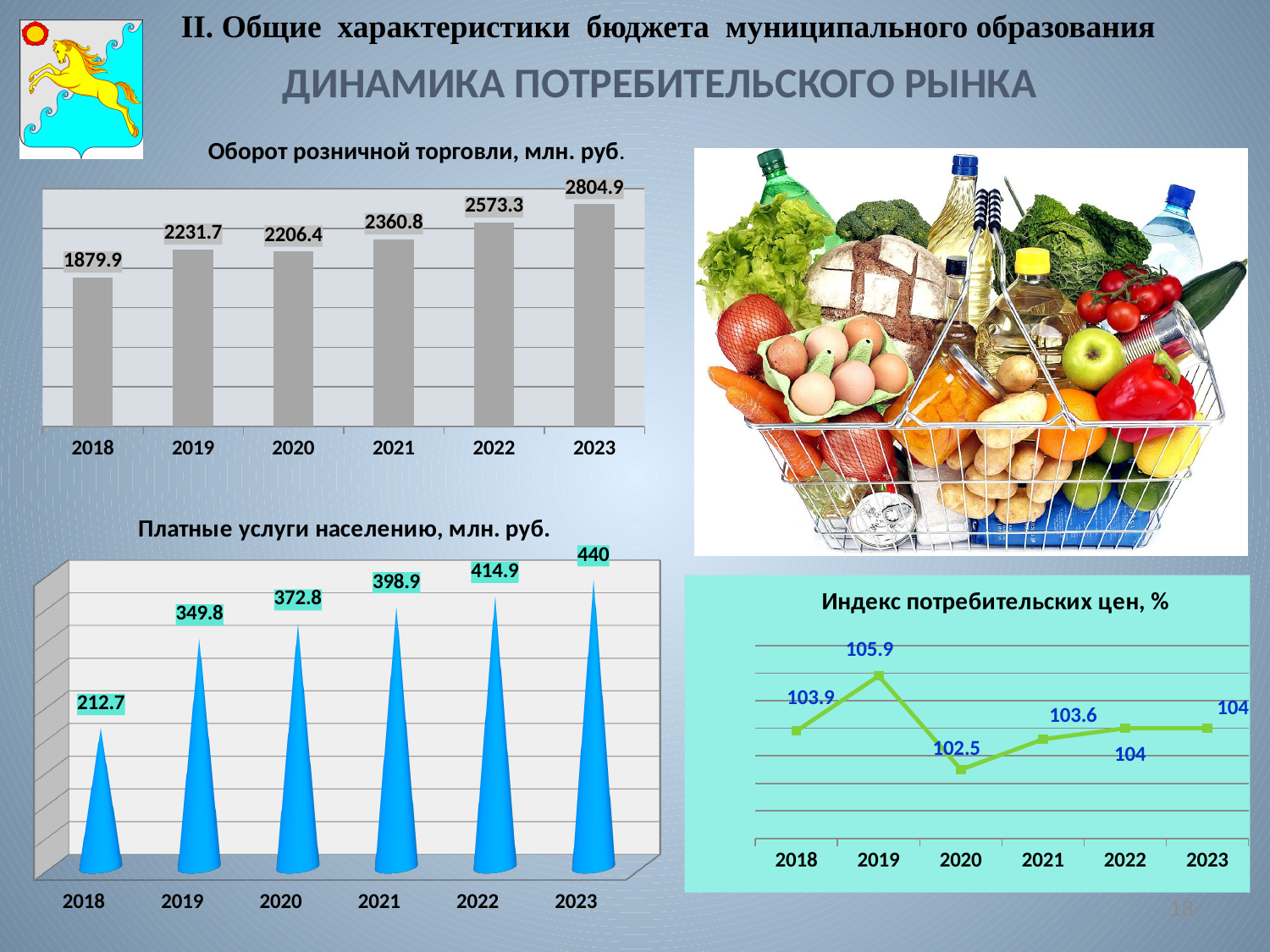
In the chart 'Платные услуги населению, млн. руб.', which year has the highest value? 2023 Do the values in the chart 'Платные услуги населению, млн. руб.' rise or fall from 2018 to 2023? rise In the chart 'Платные услуги населению, млн. руб.', what is the difference between the 2019 and 2018 values? 137.1 In the chart 'Оборот розничной торговли, млн. руб.', what is the difference between the 2023 and 2022 values? 231.6 What type of chart is 'Индекс потребительских цен, %'? line chart In the chart 'Индекс потребительских цен, %', what is the value for 2019? 105.9 In the chart 'Оборот розничной торговли, млн. руб.', which is larger: the value for 2019 or the value for 2020? 2019 How many years are shown in the chart 'Оборот розничной торговли, млн. руб.'? 6 In the chart 'Оборот розничной торговли, млн. руб.', which year has the lowest value? 2018 In the chart 'Оборот розничной торговли, млн. руб.', what is the value for 2021? 2360.8 In the chart 'Индекс потребительских цен, %', which year has the lowest value? 2020 In the chart 'Платные услуги населению, млн. руб.', what is the value for 2020? 372.8